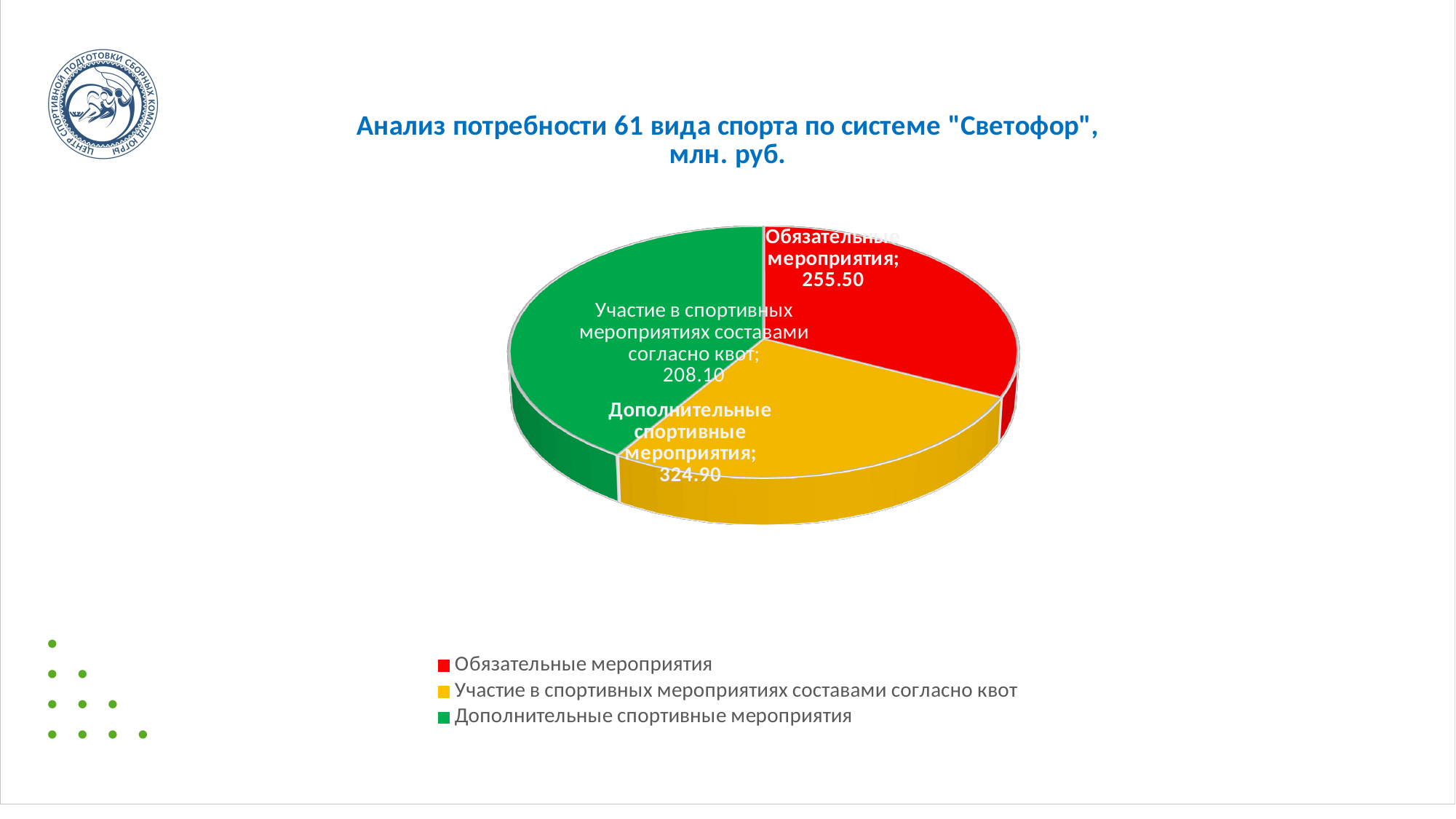
What is the difference between the values for Обязательные мероприятия and Участие в спортивных мероприятиях составами согласно квот? 47.40 What is the value for Участие в спортивных мероприятиях составами согласно квот? 208.10 Which category has the largest value? Дополнительные спортивные мероприятия What type of chart is shown on the slide? Pie chart Which category has the smallest value? Участие в спортивных мероприятиях составами согласно квот What is the value for Обязательные мероприятия? 255.50 How many slices does the pie chart have? 3 Which is larger: Обязательные мероприятия or Участие в спортивных мероприятиях составами согласно квот? Обязательные мероприятия What is the value for Дополнительные спортивные мероприятия? 324.90 What colour represents Дополнительные спортивные мероприятия in the legend? Green What is the title of the chart? Анализ потребности 61 вида спорта по системе "Светофор", млн. руб. What is the difference between the values for Дополнительные спортивные мероприятия and Обязательные мероприятия? 69.40